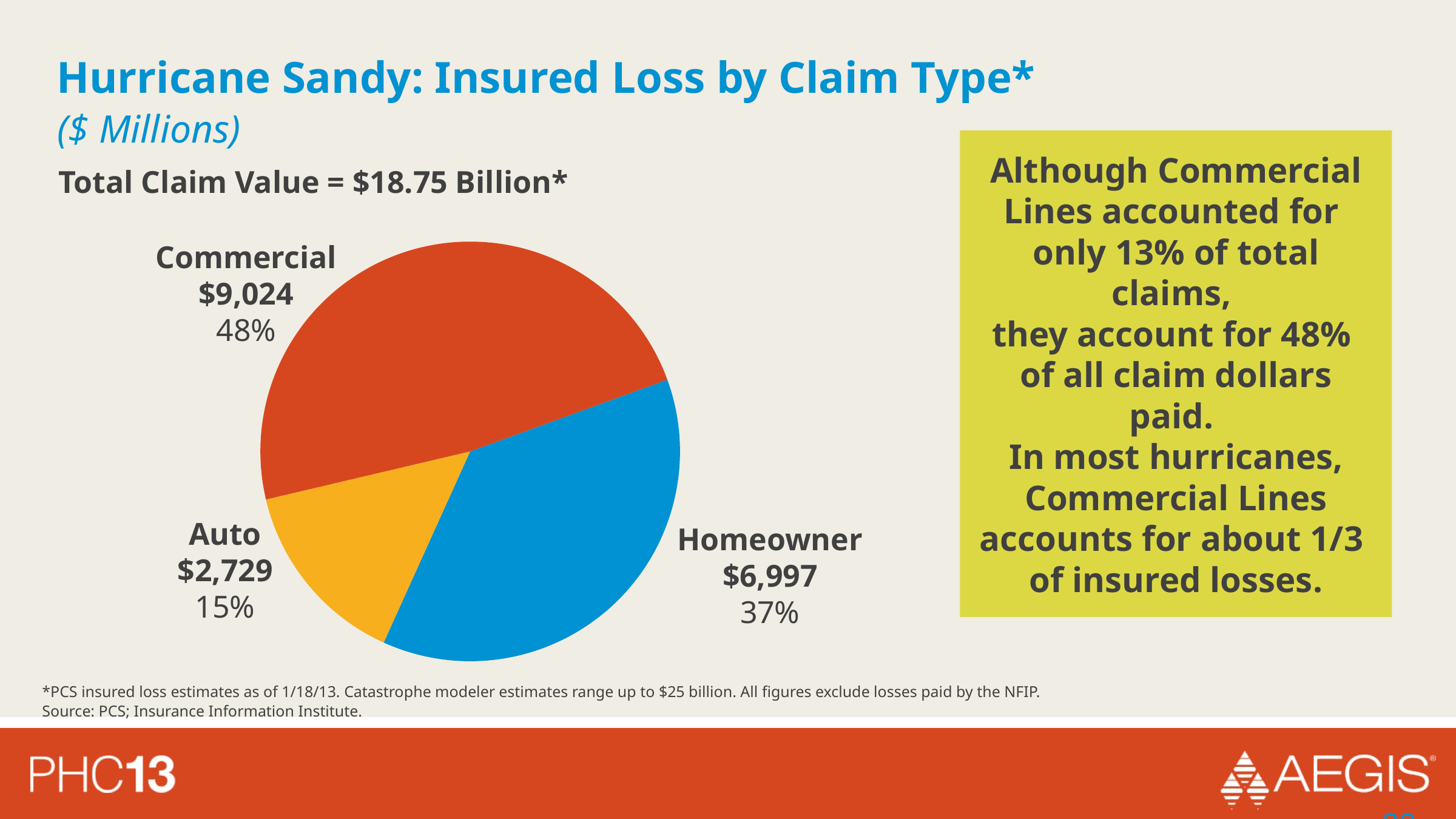
What is the difference between the Commercial and Homeowner insured loss values? $2,027 Which claim type has the largest insured loss? Commercial What is the insured loss value for Homeowner claims? $6,997 What kind of chart is shown on the slide? Pie chart What is the insured loss value for Commercial claims? $9,024 What colour is the Commercial slice of the pie? Red Which is larger, the Homeowner insured loss or the Auto insured loss? Homeowner What is the insured loss value for Auto claims? $2,729 How many claim types are shown in the pie chart? 3 Which claim type has the smallest insured loss? Auto What share of the pie does the Auto slice represent? 15% What share of the pie does the Homeowner slice represent? 37%